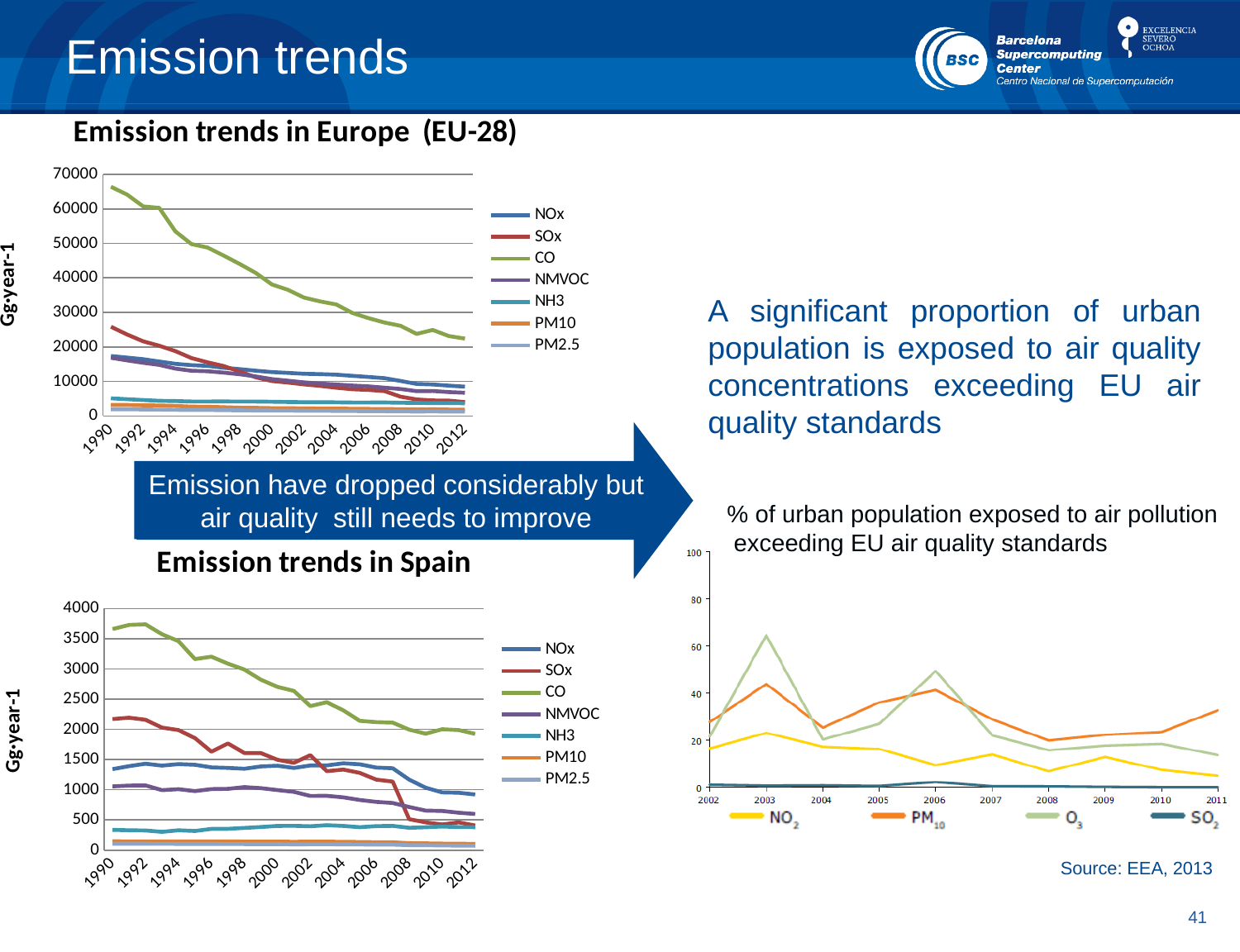
In the 'Emission trends in Spain' chart, which is larger in 1990, NOx or SOx? SOx In the '% of urban population exposed to air pollution exceeding EU air quality standards' chart, is the O3 value in 2003 greater or less than 60? greater In the '% of urban population exposed to air pollution exceeding EU air quality standards' chart, which pollutant has the lowest values across all years? SO2 In the 'Emission trends in Europe (EU-28)' chart, is the SOx value in 2012 greater or less than 10000? less In the 'Emission trends in Spain' chart, is the CO value in 1990 greater or less than 3500? greater In the 'Emission trends in Europe (EU-28)' chart, which pollutant has the highest emissions throughout the period? CO In the 'Emission trends in Spain' chart, which pollutant has the highest emissions throughout the period? CO In the 'Emission trends in Europe (EU-28)' chart, do CO emissions rise or fall from 1990 to 2012? fall What kind of chart is the 'Emission trends in Europe (EU-28)' chart? line chart How many series does the legend of the '% of urban population exposed to air pollution exceeding EU air quality standards' chart list? 4 How many series does the legend of the 'Emission trends in Europe (EU-28)' chart list? 7